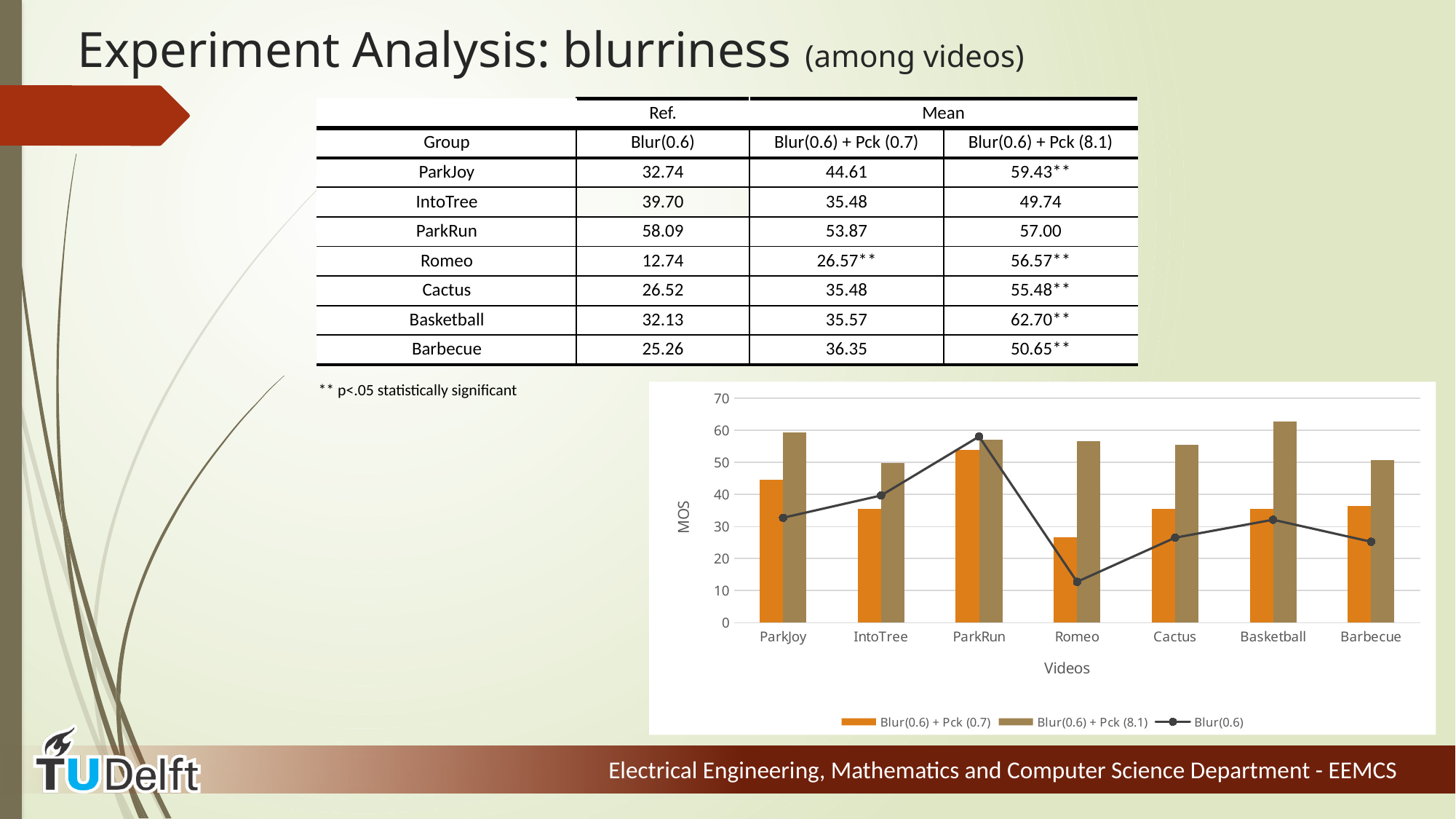
Which video has the lowest Blur(0.6) + Pck (0.7) bar? Romeo Which video has the highest Blur(0.6) + Pck (8.1) bar? Basketball How many videos are shown along the x axis of the chart? 7 How many series does the chart legend list? 3 Which video has the highest Blur(0.6) + Pck (0.7) bar? ParkRun Is the Blur(0.6) + Pck (0.7) value for Cactus greater or less than 40? less For ParkJoy, which is larger: the Blur(0.6) + Pck (0.7) bar or the Blur(0.6) + Pck (8.1) bar? Blur(0.6) + Pck (8.1) Is the Blur(0.6) + Pck (8.1) value for Romeo greater or less than 50? greater What is the Blur(0.6) + Pck (8.1) value for Basketball, as printed in the table? 62.70 Which video has the lowest point on the Blur(0.6) line? Romeo What kind of chart is shown on the slide? bar chart with a line series What is the label on the y axis of the chart? MOS